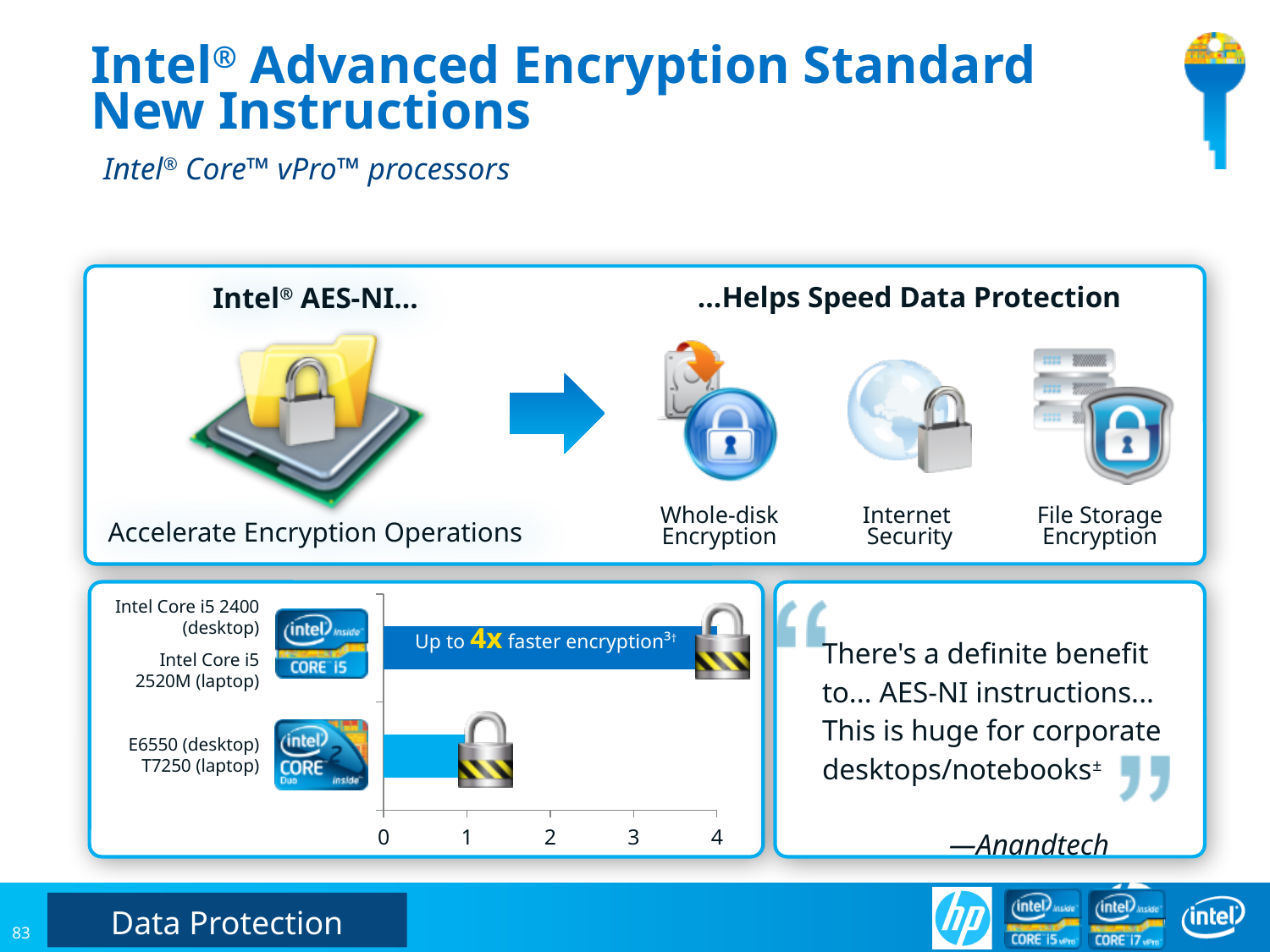
How many processor categories are plotted in the bar chart? 2 What is the highest value shown on the x axis of the bar chart? 4 How many tick labels are shown on the x axis of the bar chart? 5 Is the bar for the Intel Core i5 2400 / 2520M longer or shorter than the bar for the E6550 / T7250? Longer According to the label on the top bar, how much faster is encryption with the Intel Core i5 processors? Up to 4x faster encryption Which processor category has the shorter bar in the chart? E6550 (desktop) / T7250 (laptop) Is the value for the Intel Core i5 2400 / 2520M bar greater or less than 3? greater Is the value for the E6550 (desktop) / T7250 (laptop) bar greater or less than 2? less Which processor category has the longer bar in the chart? Intel Core i5 2400 (desktop) / Intel Core i5 2520M (laptop) What kind of chart is shown in the lower-left panel of the slide? Bar chart